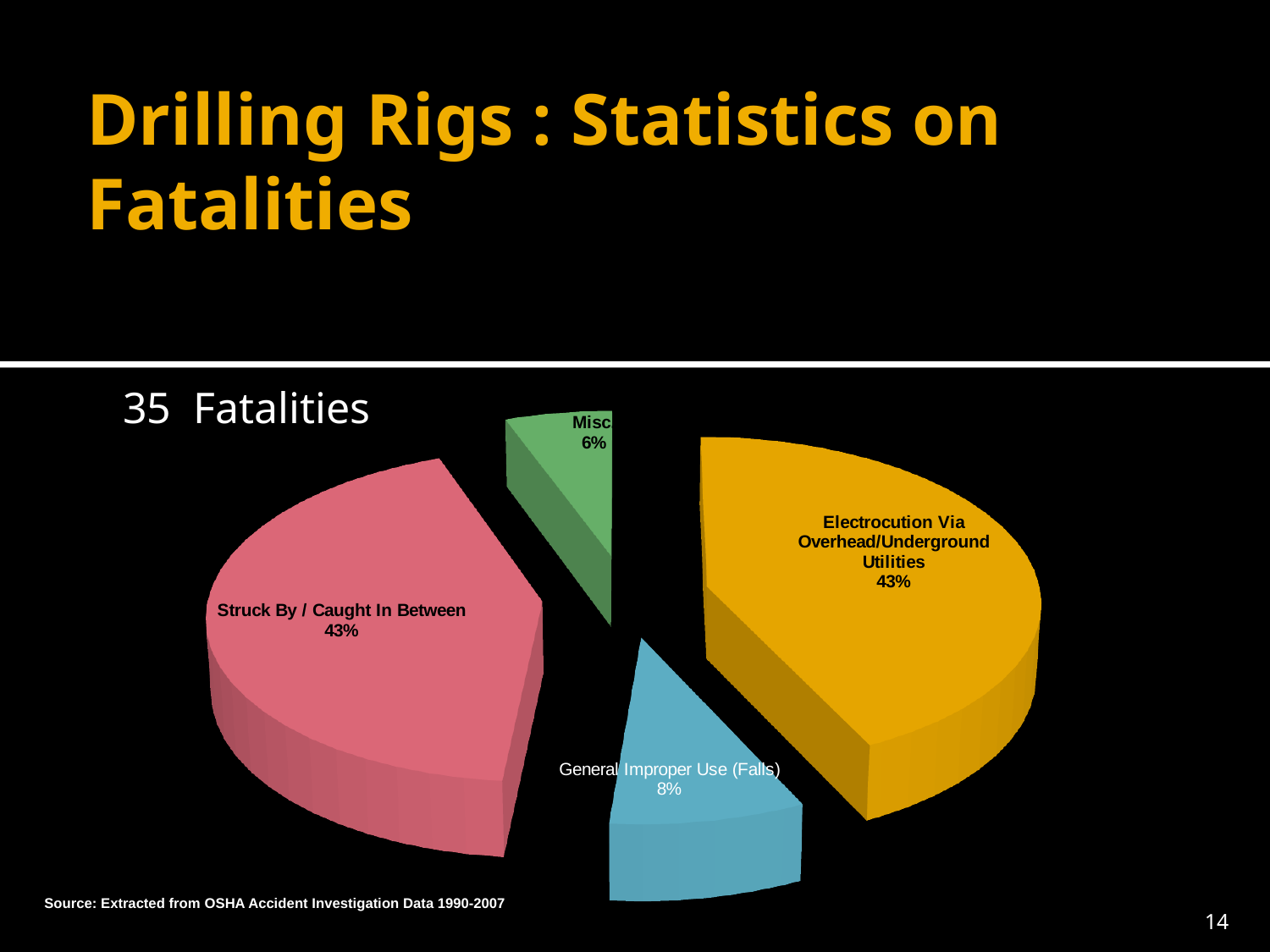
What is the difference in percentage points between the General Improper Use (Falls) share and the Misc share? 2% Which category has the smallest share of the pie? Misc What share of fatalities is attributed to Struck By / Caught In Between? 43% What is the difference in percentage points between the Struck By / Caught In Between share and the General Improper Use (Falls) share? 35% What share of fatalities is attributed to General Improper Use (Falls)? 8% What colour is the Electrocution Via Overhead/Underground Utilities slice? Yellow/orange How many fatalities does the chart represent in total, according to the text next to it? 35 Which is larger, the share for General Improper Use (Falls) or the share for Misc? General Improper Use (Falls) What share of fatalities is attributed to Electrocution Via Overhead/Underground Utilities? 43% How many categories are shown in the pie chart? 4 What share of fatalities is attributed to Misc? 6% What kind of chart is shown on the slide? Pie chart